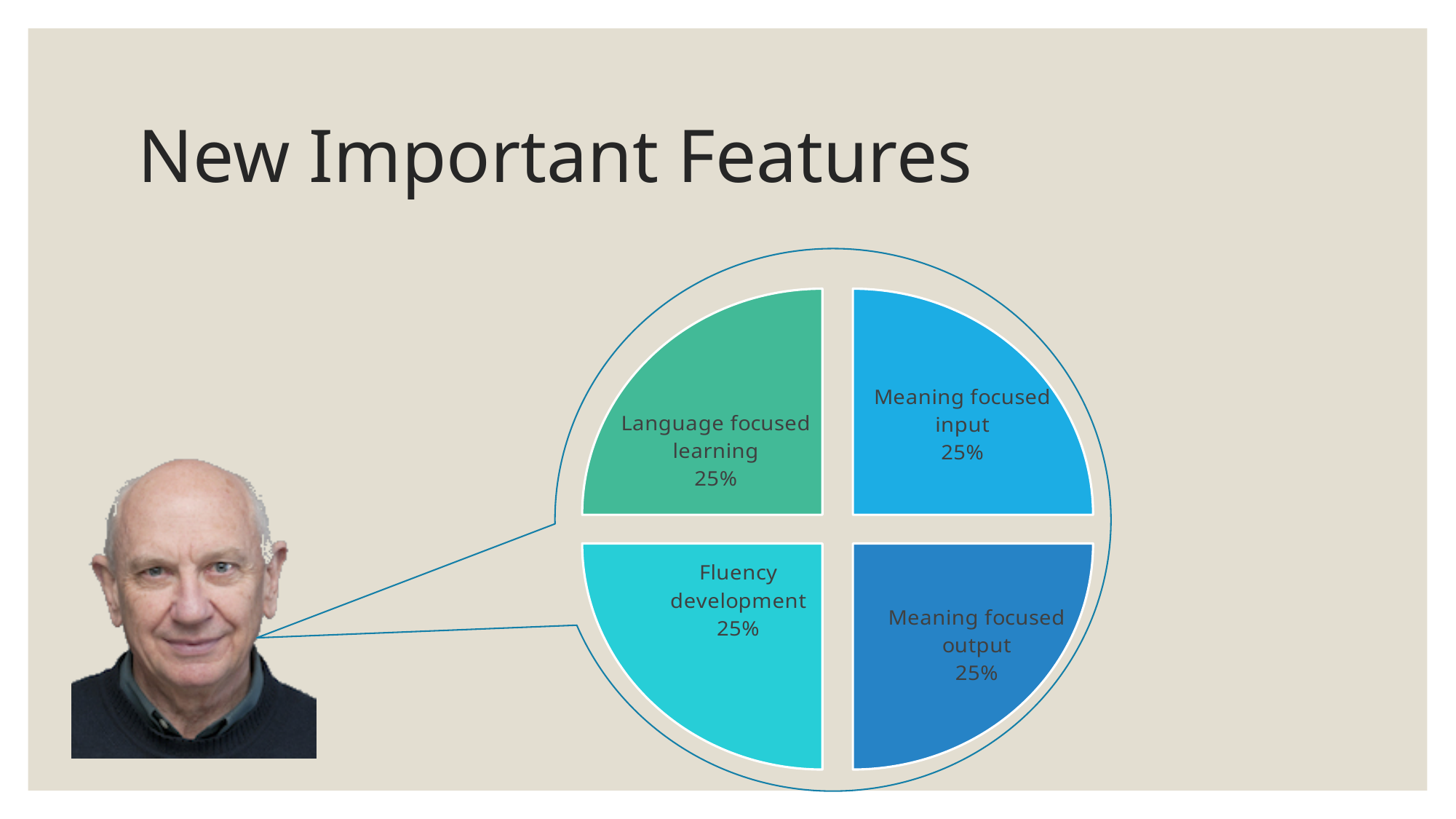
What value is shown for Meaning focused output? 25% What is the title of the slide containing the pie chart? New Important Features What share of the pie does Meaning focused input have? 25% What value is shown for Language focused learning? 25% Which slice of the pie chart is labelled Fluency development: the top-left, top-right, bottom-left or bottom-right? bottom-left What is the combined share of Meaning focused input and Meaning focused output? 50% What share of the pie does Fluency development have? 25% What kind of chart is shown on the slide? pie chart What is the difference between the values for Language focused learning and Meaning focused output? 0% How many slices does the pie chart have? 4